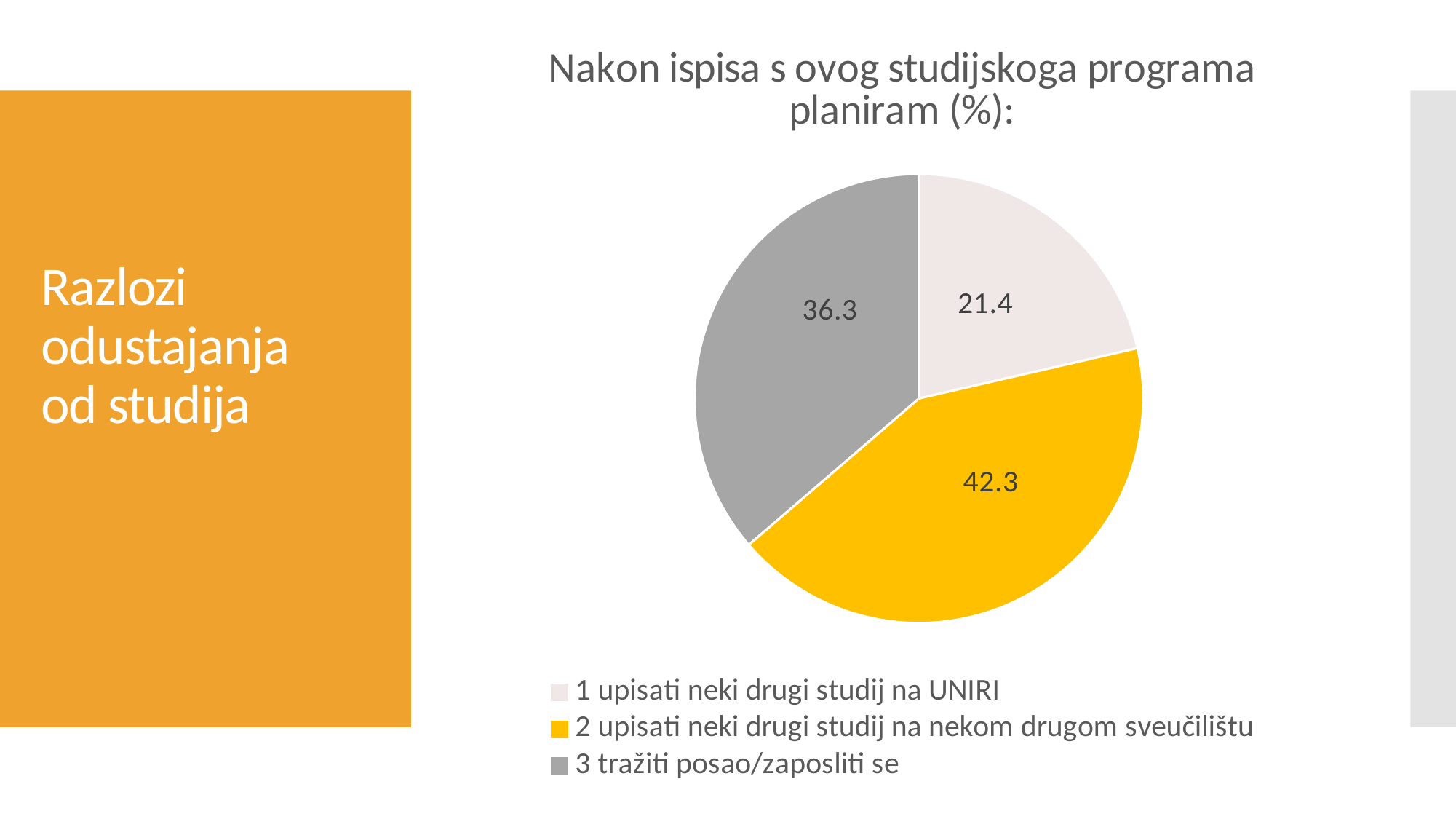
Which is larger: the slice for '3 tražiti posao/zaposliti se' or the slice for '1 upisati neki drugi studij na UNIRI'? 3 tražiti posao/zaposliti se What value is shown for the slice '2 upisati neki drugi studij na nekom drugom sveučilištu'? 42.3 Which category has the largest slice of the pie? 2 upisati neki drugi studij na nekom drugom sveučilištu Which category has the smallest slice of the pie? 1 upisati neki drugi studij na UNIRI What value is shown for the slice '3 tražiti posao/zaposliti se'? 36.3 What is the difference between the values for '3 tražiti posao/zaposliti se' and '1 upisati neki drugi studij na UNIRI'? 14.9 How many slices does the pie chart have? 3 What colour is the slice for '3 tražiti posao/zaposliti se'? Grey What is the difference between the values for '2 upisati neki drugi studij na nekom drugom sveučilištu' and '3 tražiti posao/zaposliti se'? 6.0 What is the title of the chart? Nakon ispisa s ovog studijskoga programa planiram (%): What kind of chart is shown on the slide? Pie chart What value is shown for the slice '1 upisati neki drugi studij na UNIRI'? 21.4